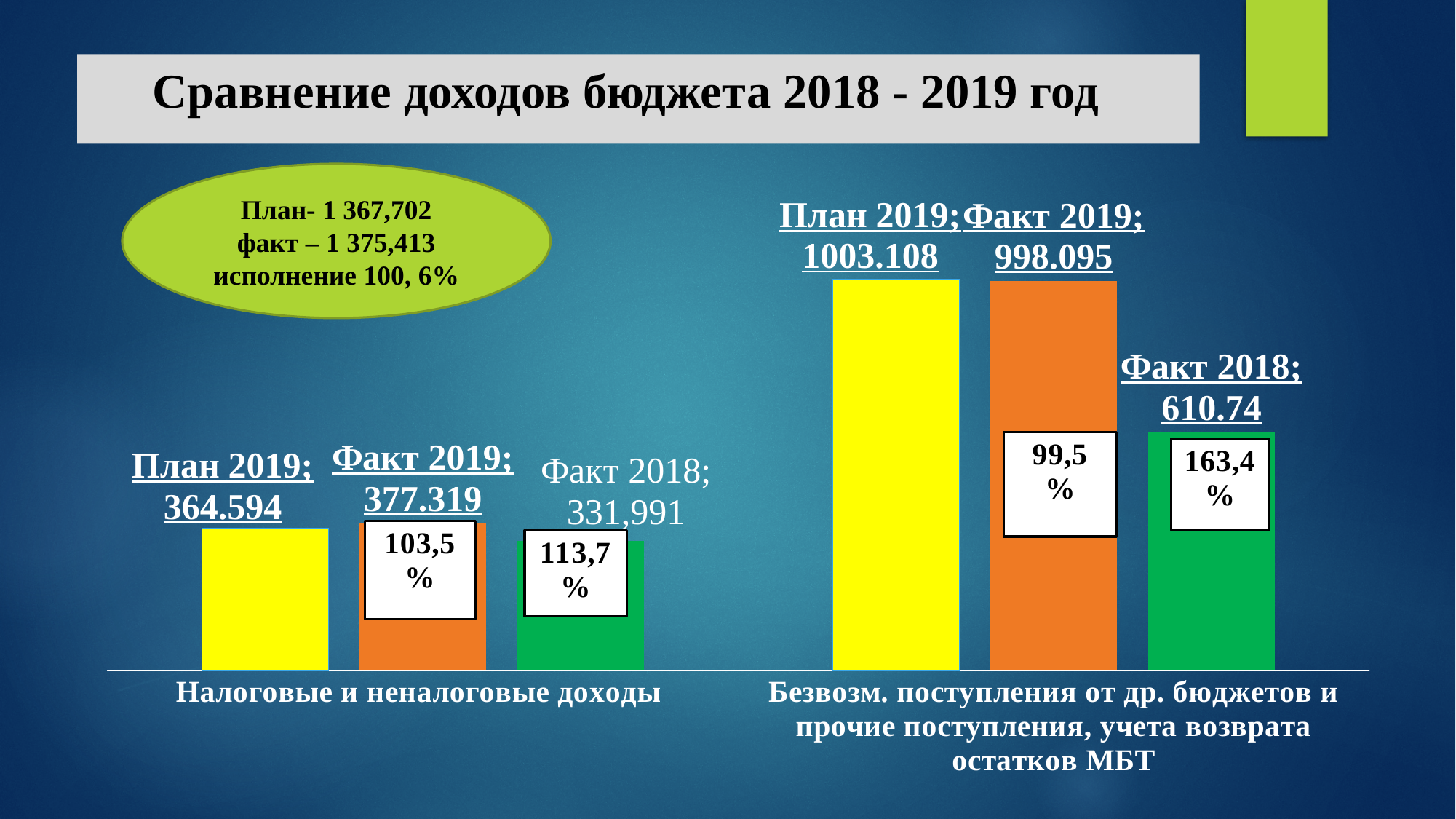
What is the value of Факт 2018 for the category Налоговые и неналоговые доходы? 331,991 How many bars are shown for each category in the chart? 3 What type of chart is shown on the slide? Bar chart What is the value of План 2019 for the category Налоговые и неналоговые доходы? 364.594 Which is larger in the category Безвозм. поступления от др. бюджетов и прочие поступления, учета возврата остатков МБТ: План 2019 or Факт 2019? План 2019 How many categories are shown on the x axis of the chart? 2 What is the difference between Факт 2019 and План 2019 in the category Налоговые и неналоговые доходы? 12.725 Which bar is the highest in the category Безвозм. поступления от др. бюджетов и прочие поступления, учета возврата остатков МБТ? План 2019 Which bar is the lowest in the category Налоговые и неналоговые доходы? Факт 2018 What is the value of Факт 2019 for the category Безвозм. поступления от др. бюджетов и прочие поступления, учета возврата остатков МБТ? 998.095 What percentage is shown on the Факт 2018 bar in the category Безвозм. поступления от др. бюджетов и прочие поступления, учета возврата остатков МБТ? 163,4 % What is the title of the slide? Сравнение доходов бюджета 2018 - 2019 год